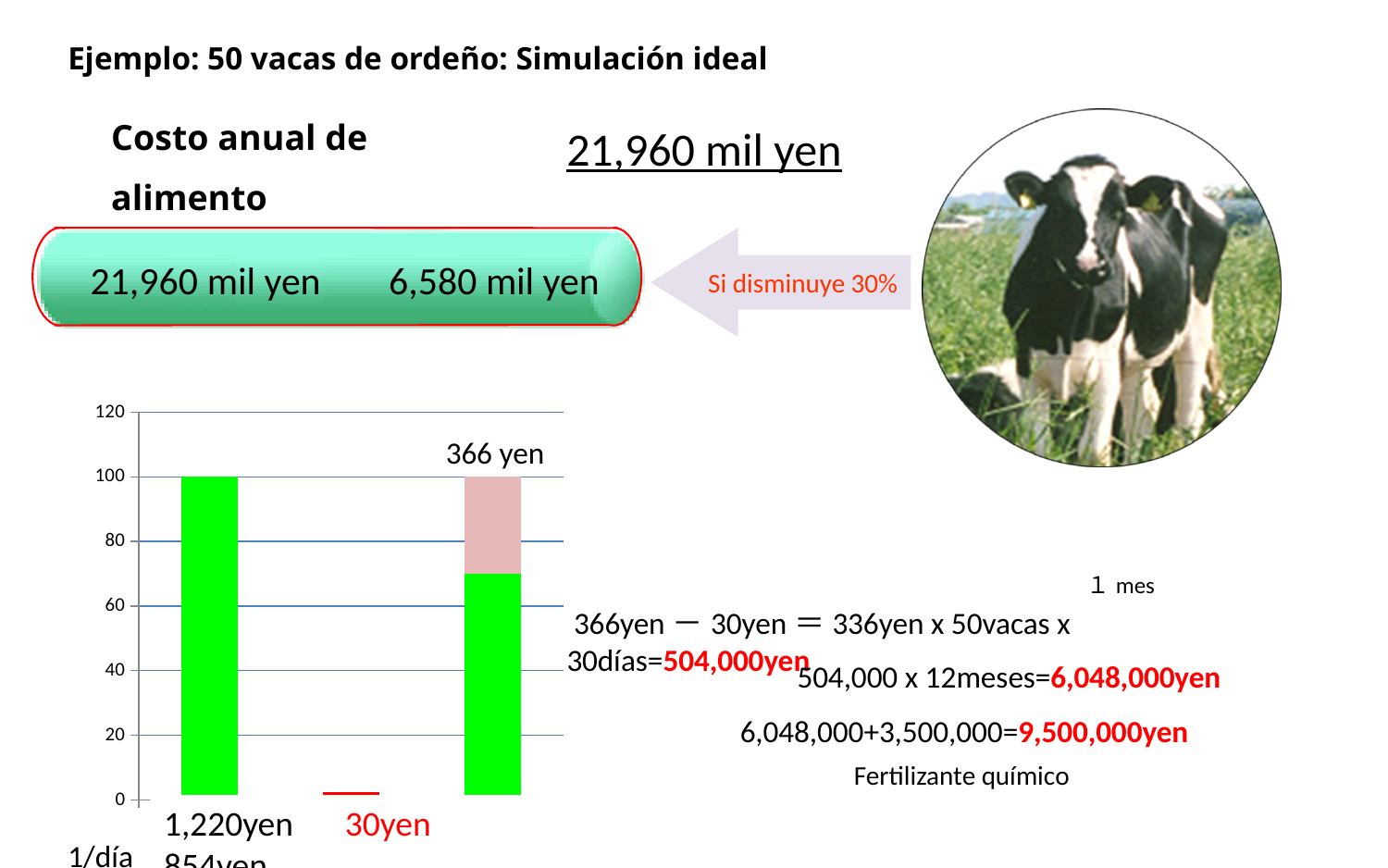
Is the green portion of the stacked bar labelled 366 yen greater or less than 80? less What value on the y axis does the top of the stacked bar labelled 366 yen reach? 100 What is the highest value shown on the chart's y axis? 120 Is the value of the bar labelled 30yen greater or less than 20? less What kind of chart is shown on the slide? bar chart How many bars are plotted in the chart? 3 What value on the y axis does the bar labelled 1,220yen reach? 100 Which is larger, the bar labelled 1,220yen or the bar labelled 30yen? 1,220yen What label is printed above the stacked bar in the chart? 366 yen Which bar in the chart is the lowest? 30yen Is the green portion of the stacked bar labelled 366 yen greater or less than 60? greater